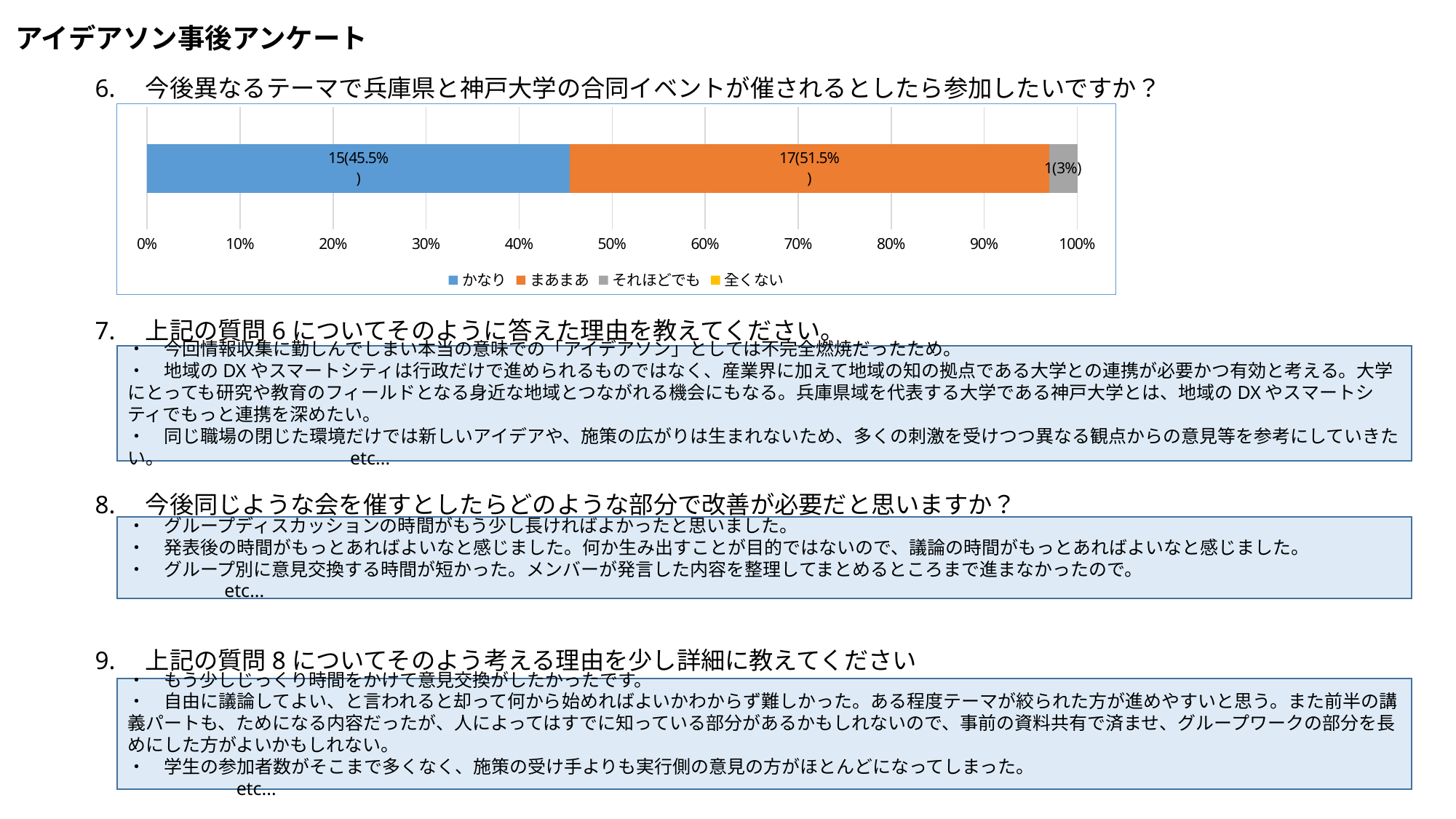
What is the difference in respondent count between まあまあ and かなり? 2 What is the data label shown for the それほどでも segment? 1(3%) Which legend entry is shown in yellow? 全くない Which response category has the largest segment in the bar? まあまあ Which is larger, the count for かなり or the count for まあまあ? まあまあ Is the share for かなり greater or less than 50%? less How many series does the legend of the chart list? 4 Which response category with a visible segment has the smallest share? それほどでも What is the total number of respondents shown across the labelled segments of the bar? 33 What is the data label shown for the まあまあ segment? 17(51.5%) What kind of chart is shown under question 6? stacked bar chart What is the data label shown for the かなり segment? 15(45.5%)